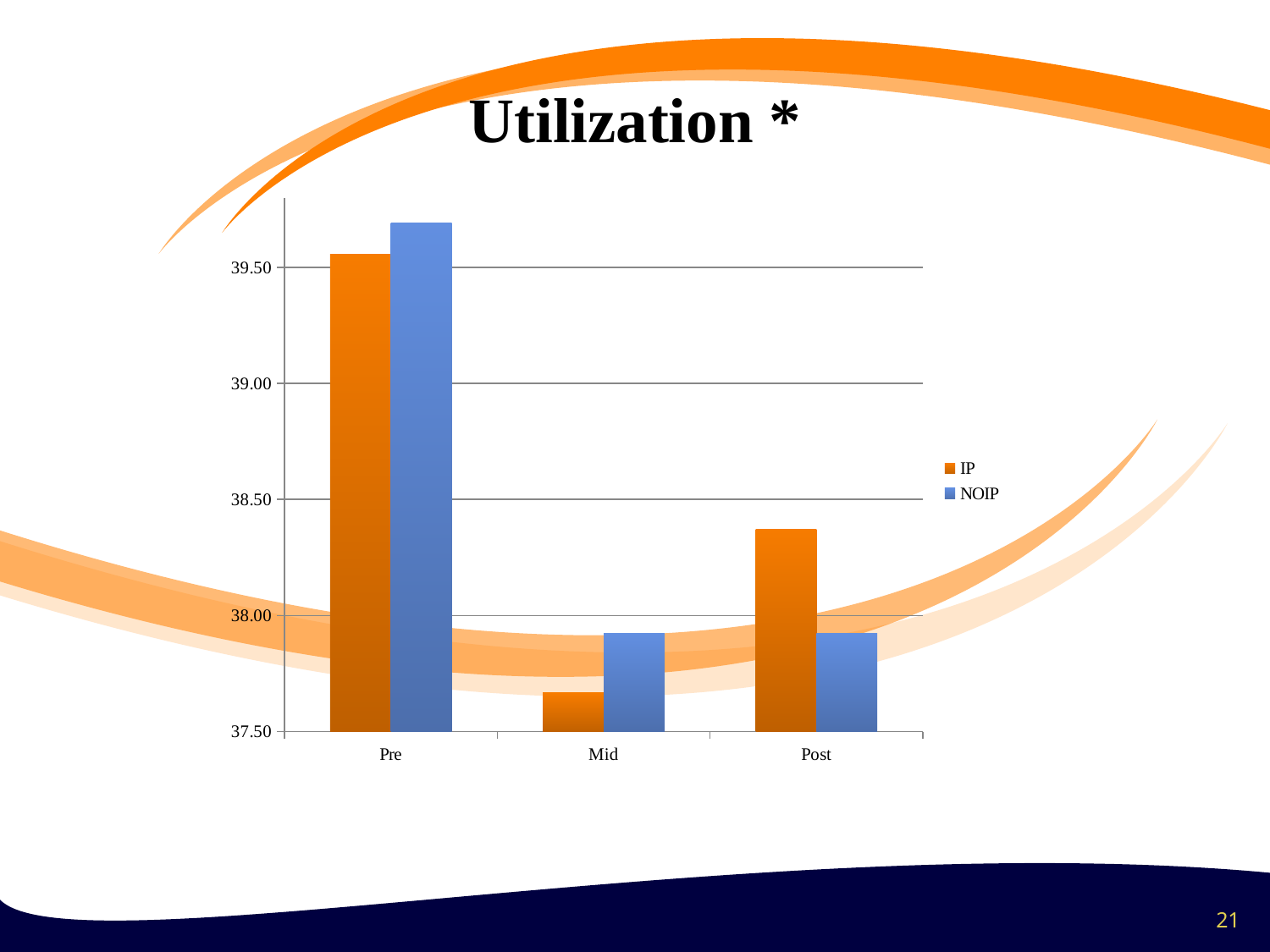
How many categories are shown on the x axis? 3 Which category has the lowest IP value? Mid Is the IP value for Mid greater or less than 38.00? less Which category has the highest IP value? Pre What kind of chart is shown on the slide? bar chart How many series does the legend list? 2 What is the title of the chart? Utilization * Which category has the highest NOIP value? Pre Is the NOIP value for Pre greater or less than 39.50? greater For Pre, which series has the larger value, IP or NOIP? NOIP For Post, which series has the larger value, IP or NOIP? IP Which series is shown in orange? IP